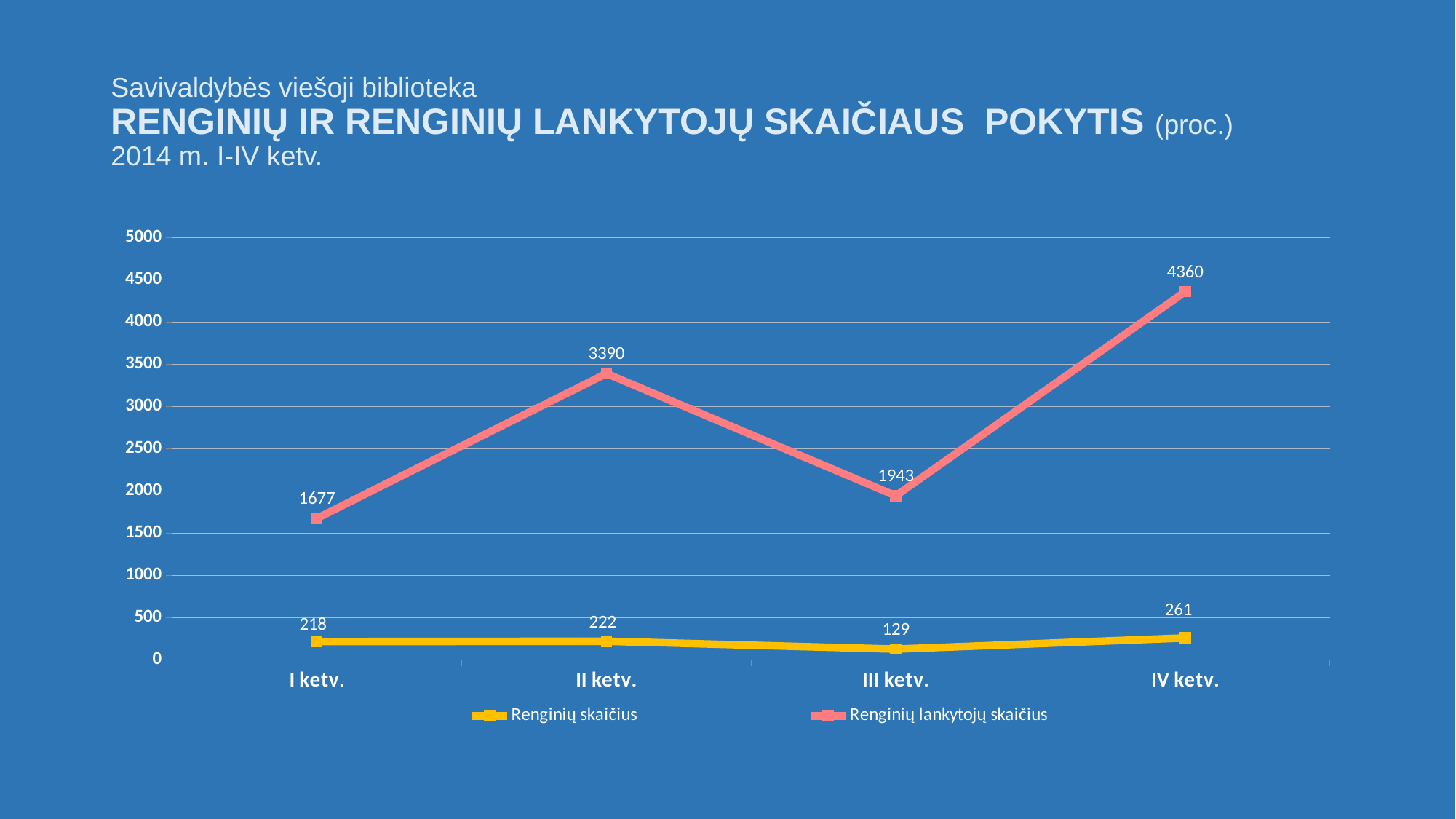
What is the difference between Renginių lankytojų skaičius in IV ketv. and III ketv.? 2417 Which is larger: Renginių skaičius in I ketv. or in IV ketv.? IV ketv. In which quarter is Renginių skaičius lowest? III ketv. Is the value of Renginių lankytojų skaičius for III ketv. greater or less than 2000? less What is the value of Renginių lankytojų skaičius for II ketv.? 3390 What kind of chart is shown on the slide? line chart What is the value of Renginių skaičius for III ketv.? 129 What is the value of Renginių lankytojų skaičius for I ketv.? 1677 How many series does the legend list? 2 In which quarter is Renginių lankytojų skaičius highest? IV ketv. Which colour is used for the Renginių lankytojų skaičius line? pink/red How many quarters are shown on the x axis? 4